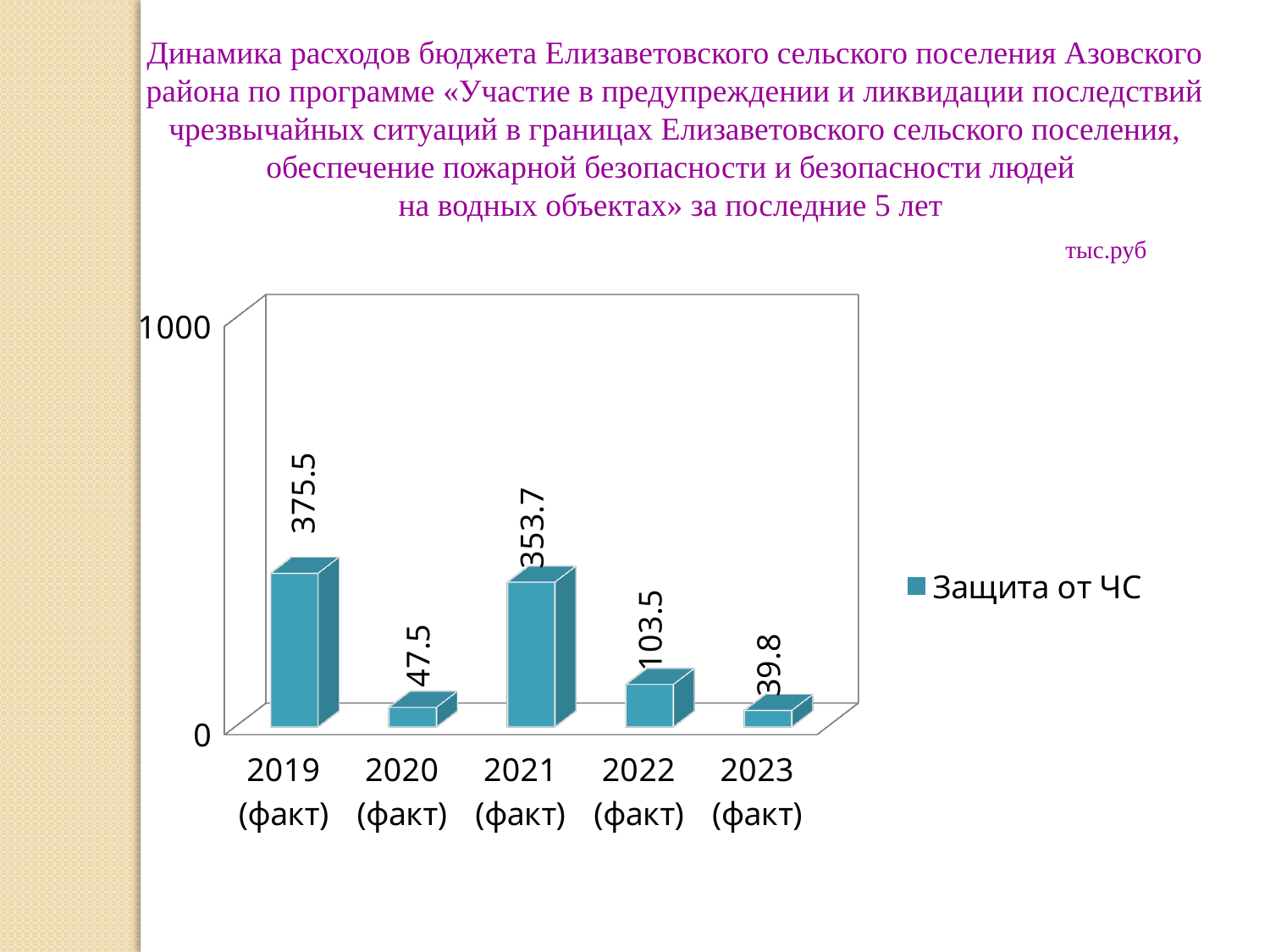
What kind of chart is shown on the slide? bar chart Which year has the highest value? 2019 (факт) Which year has the lowest value? 2023 (факт) What is the value for 2022 (факт)? 103.5 What is the value for 2023 (факт)? 39.8 Which is larger, the value for 2020 (факт) or the value for 2022 (факт)? 2022 (факт) How many years are shown on the x axis? 5 What is the difference between the values for 2019 (факт) and 2021 (факт)? 21.8 What is the difference between the values for 2022 (факт) and 2020 (факт)? 56 What is the name of the series in the legend? Защита от ЧС How many series does the legend list? 1 What is the value for 2019 (факт)? 375.5